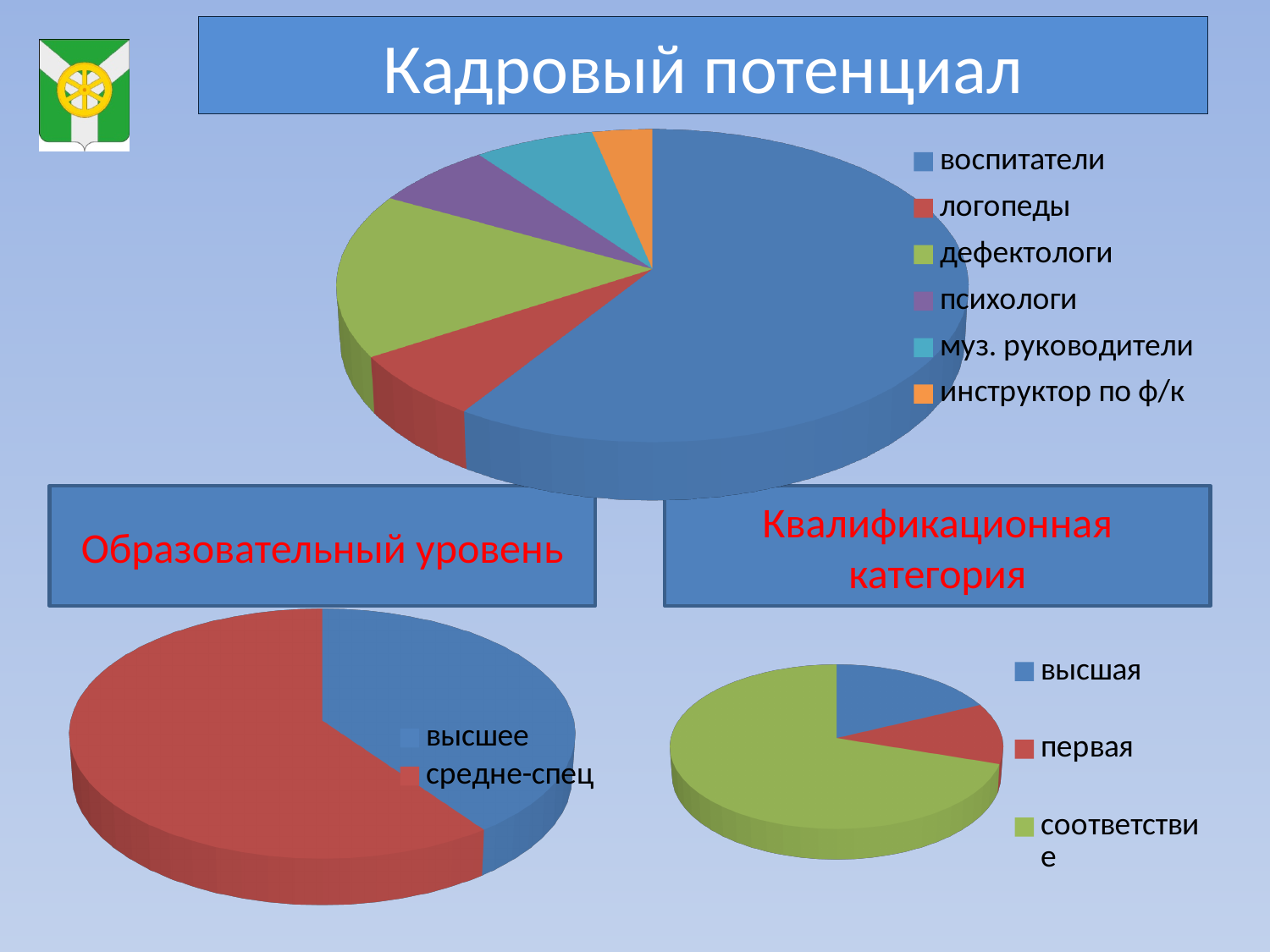
In the top chart ("Кадровый потенциал"), which slice is larger: дефектологи or логопеды? дефектологи In the bottom-right chart ("Квалификационная категория"), how many categories does the legend list? 3 What kind of chart is the top chart under the title "Кадровый потенциал"? pie chart In the bottom-left chart ("Образовательный уровень"), how many categories are shown? 2 In the bottom-left chart ("Образовательный уровень"), which category has the larger slice? средне-спец What kind of chart is the bottom-right chart ("Квалификационная категория")? pie chart In the bottom-right chart ("Квалификационная категория"), which category has the largest slice? соответствие In the top chart ("Кадровый потенциал"), which category has the smallest slice? инструктор по ф/к In the top chart ("Кадровый потенциал"), how many categories does the legend list? 6 In the top chart ("Кадровый потенциал"), what colour is the slice for муз. руководители? teal (light blue) In the top chart ("Кадровый потенциал"), which slice is larger: воспитатели or дефектологи? воспитатели In the top chart ("Кадровый потенциал"), which category has the largest slice? воспитатели